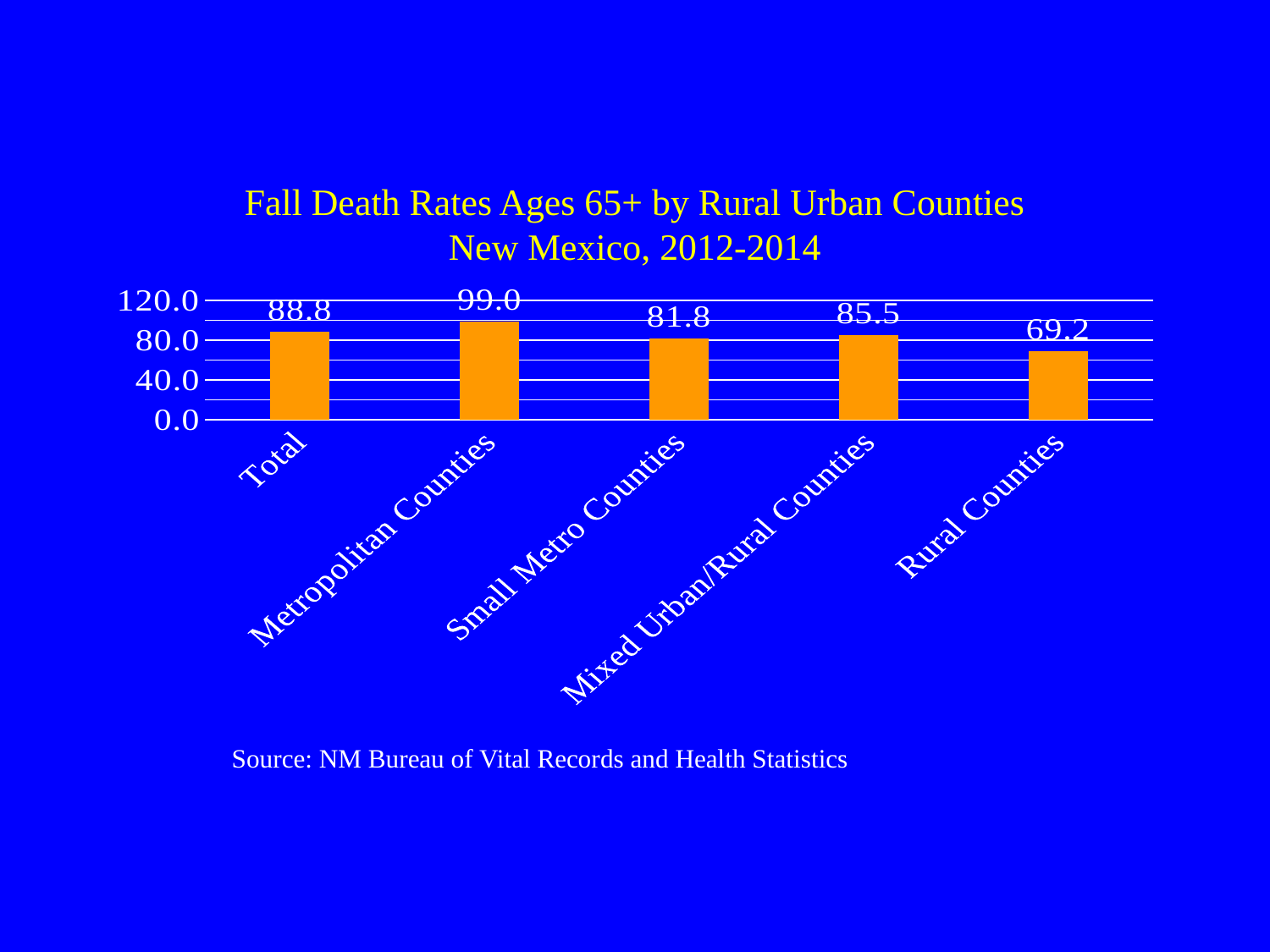
Which category has the lowest fall death rate? Rural Counties What is the difference between the values for Metropolitan Counties and Rural Counties? 29.8 What kind of chart is shown on the slide? bar chart How many categories are shown on the x axis? 5 Which category has the highest fall death rate? Metropolitan Counties What is the title of the chart? Fall Death Rates Ages 65+ by Rural Urban Counties New Mexico, 2012-2014 Which is larger, the value for Small Metro Counties or Mixed Urban/Rural Counties? Mixed Urban/Rural Counties What is the value for Mixed Urban/Rural Counties? 85.5 What is the fall death rate for Rural Counties? 69.2 What is the value shown for Total? 88.8 What is the fall death rate for Metropolitan Counties? 99.0 Is the value for Small Metro Counties greater or less than 80.0? greater